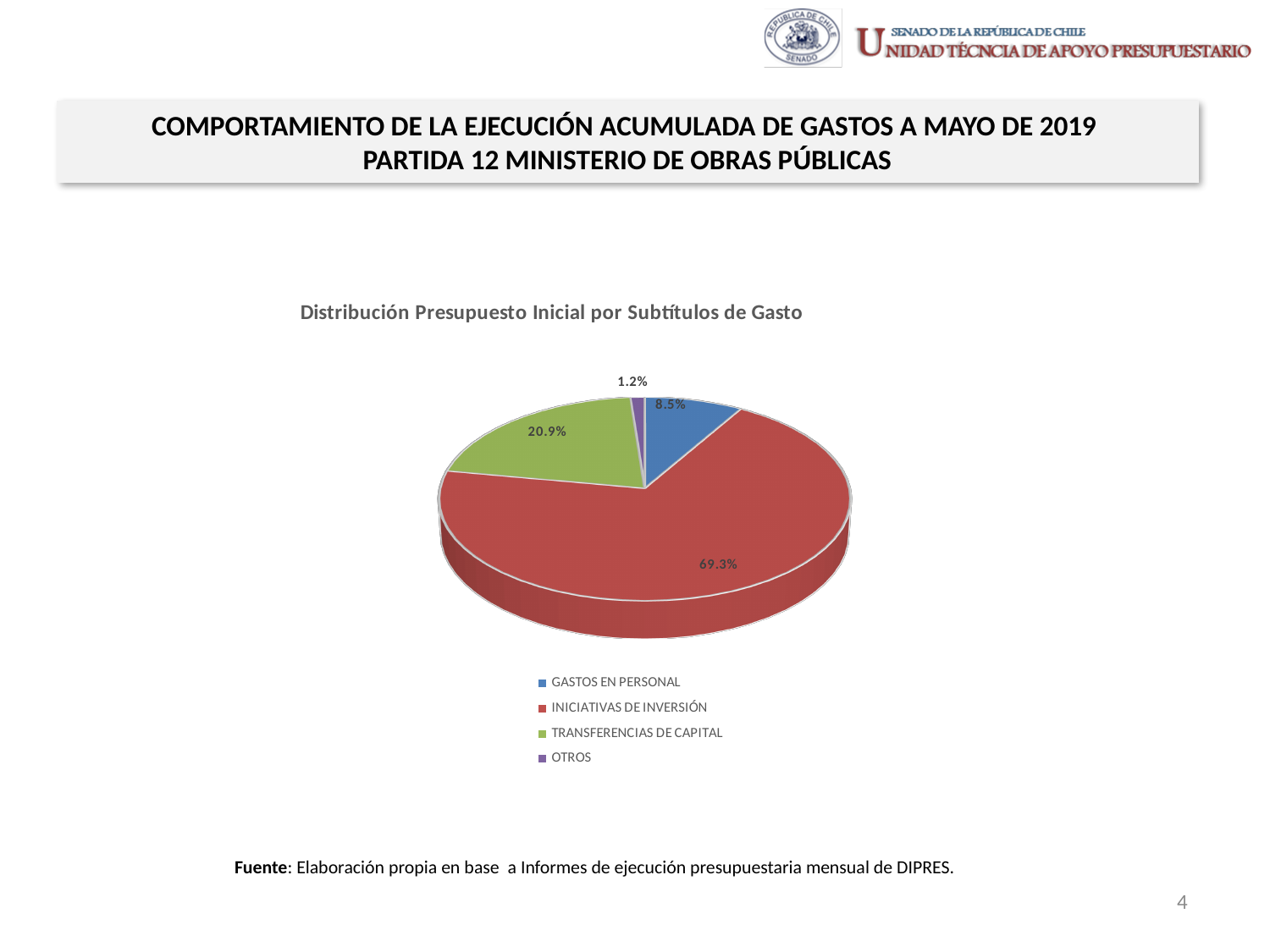
What type of chart is shown on the slide? Pie chart What share of the pie does INICIATIVAS DE INVERSIÓN represent? 69.3% What share of the pie does GASTOS EN PERSONAL represent? 8.5% What is the difference in percentage points between INICIATIVAS DE INVERSIÓN and TRANSFERENCIAS DE CAPITAL? 48.4 What share of the pie does TRANSFERENCIAS DE CAPITAL represent? 20.9% What is the title of the chart? Distribución Presupuesto Inicial por Subtítulos de Gasto Which category has the smallest slice of the pie? OTROS How many categories does the legend list? 4 Which category has the largest slice of the pie? INICIATIVAS DE INVERSIÓN What colour is the slice for TRANSFERENCIAS DE CAPITAL? Green Which is larger, the share for GASTOS EN PERSONAL or the share for TRANSFERENCIAS DE CAPITAL? TRANSFERENCIAS DE CAPITAL